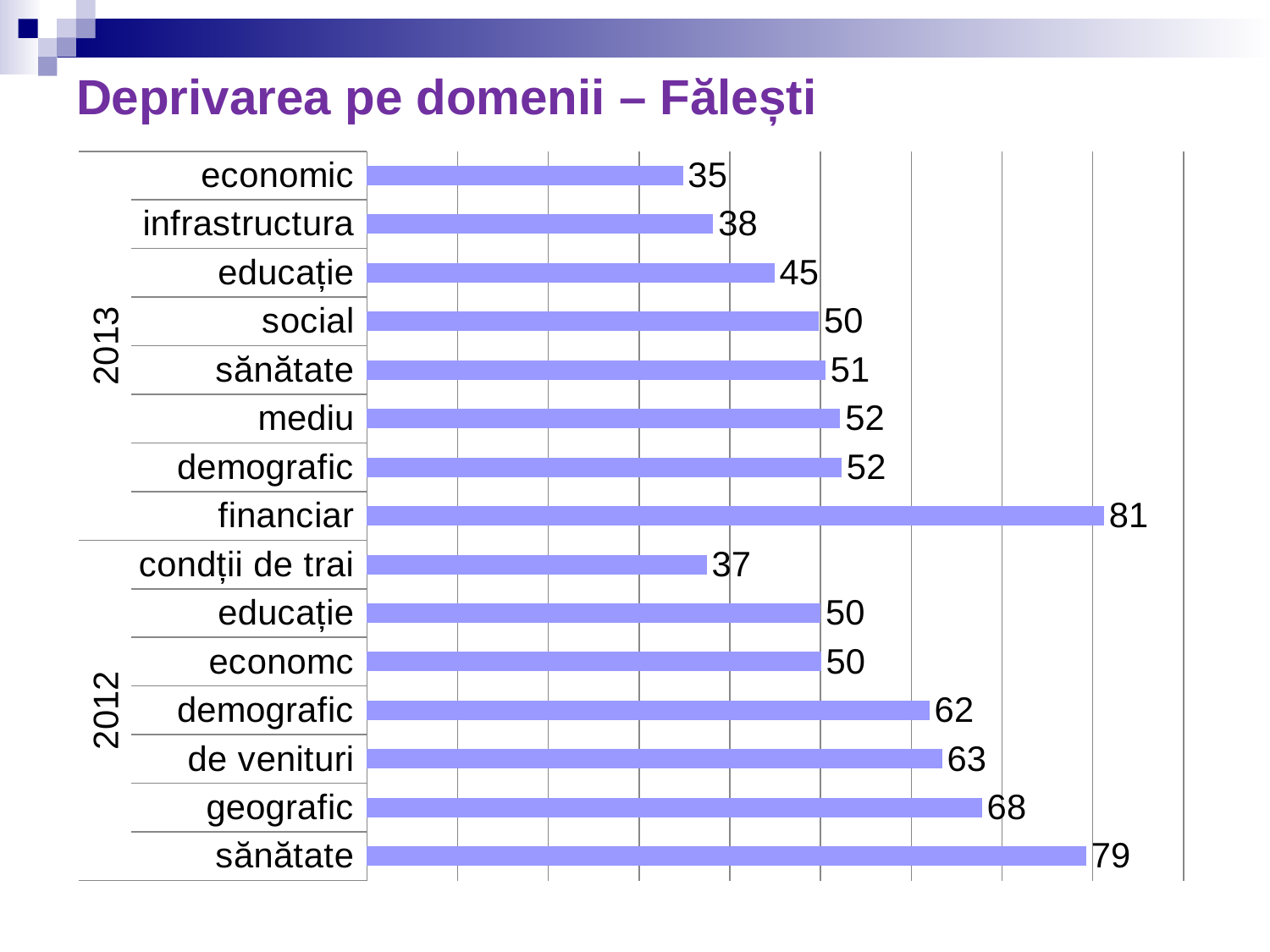
How many categories are shown in the 2013 group? 8 How many bars are plotted in the chart in total? 15 What is the value for financiar in the 2013 group? 81 What kind of chart is shown on the slide? bar chart Which category has the lowest value in the 2013 group? economic What is the value for geografic in the 2012 group? 68 What is the difference between the value for sănătate in 2012 and the value for sănătate in 2013? 28 What is the difference between financiar in 2013 and de venituri in 2012? 18 Which is larger: demografic in 2012 or demografic in 2013? demografic in 2012 Which category has the highest value in the 2012 group? sănătate What is the value for infrastructura in the 2013 group? 38 What is the title of the slide? Deprivarea pe domenii – Fălești